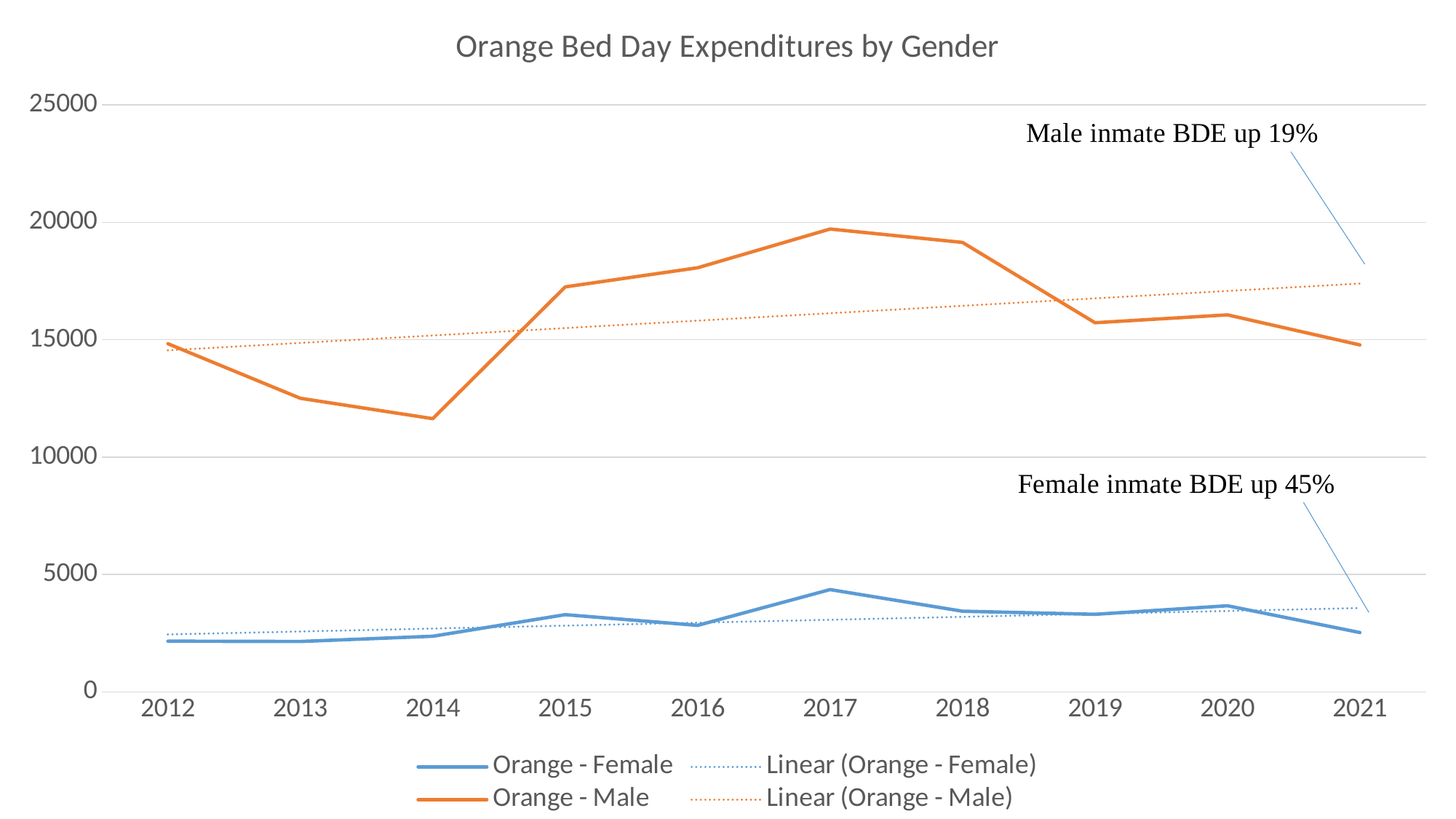
Is the Orange - Male value for 2017 greater or less than 15000? greater Does the dotted Linear (Orange - Male) trendline rise or fall from 2012 to 2021? rise In which year does the Orange - Male series reach its lowest value? 2014 Which is larger for Orange - Male: the value in 2018 or the value in 2019? 2018 According to the annotation on the chart, by what percentage is female inmate BDE up? 45% How many years are plotted along the x axis? 10 Is the Orange - Male value for 2014 greater or less than 15000? less Is the Orange - Female value for 2017 greater or less than 5000? less In which year does the Orange - Male series reach its highest value? 2017 How many entries does the legend list? 4 In which year does the Orange - Female series reach its highest value? 2017 What kind of chart is shown on the slide? line chart